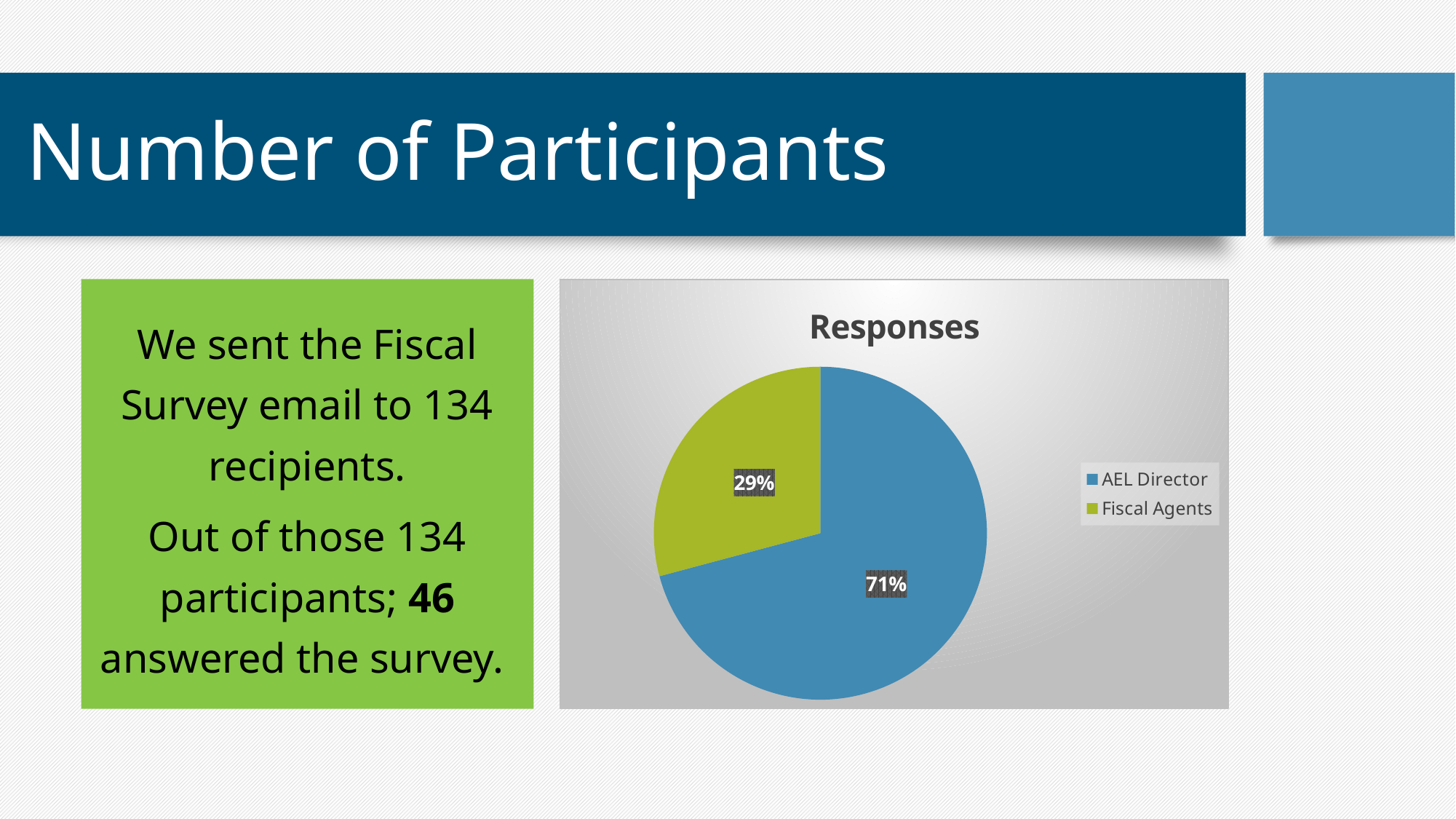
What is the difference in percentage points between the AEL Director and Fiscal Agents slices? 42 Which slice is larger, AEL Director or Fiscal Agents? AEL Director What colour is the Fiscal Agents slice? Green How many entries does the legend list? 2 What kind of chart is shown on the slide? Pie chart How many slices does the pie chart have? 2 What is the title of the chart? Responses Which category has the smallest slice of the pie? Fiscal Agents What share of responses came from Fiscal Agents? 29% What share of responses came from AEL Directors? 71% Which category has the largest slice of the pie? AEL Director